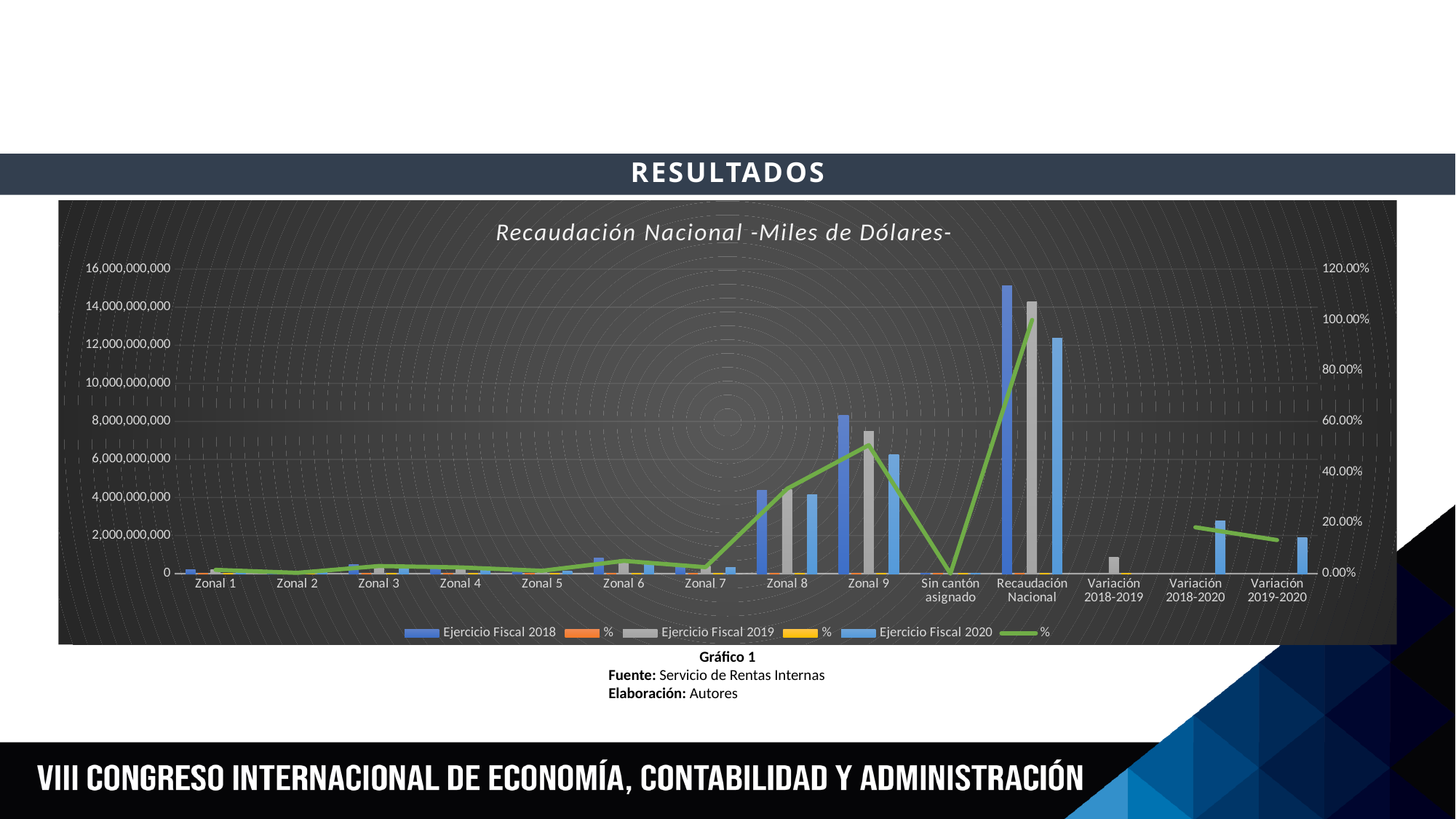
Which category has the tallest Ejercicio Fiscal 2018 bar? Recaudación Nacional Among the Zonal categories, which has the tallest Ejercicio Fiscal 2018 bar? Zonal 9 What is the title of the chart? Recaudación Nacional -Miles de Dólares- Is the Ejercicio Fiscal 2018 value for Zonal 9 greater or less than 8,000,000,000? greater What kind of chart is shown on the slide? Combined bar and line chart Is the Ejercicio Fiscal 2020 value for Recaudación Nacional greater or less than 12,000,000,000? greater How many categories are shown along the x axis of the chart? 14 Is the Ejercicio Fiscal 2018 value for Recaudación Nacional greater or less than 14,000,000,000? greater How many entries does the chart legend list? 6 For Recaudación Nacional, which is larger: the Ejercicio Fiscal 2018 bar or the Ejercicio Fiscal 2020 bar? Ejercicio Fiscal 2018